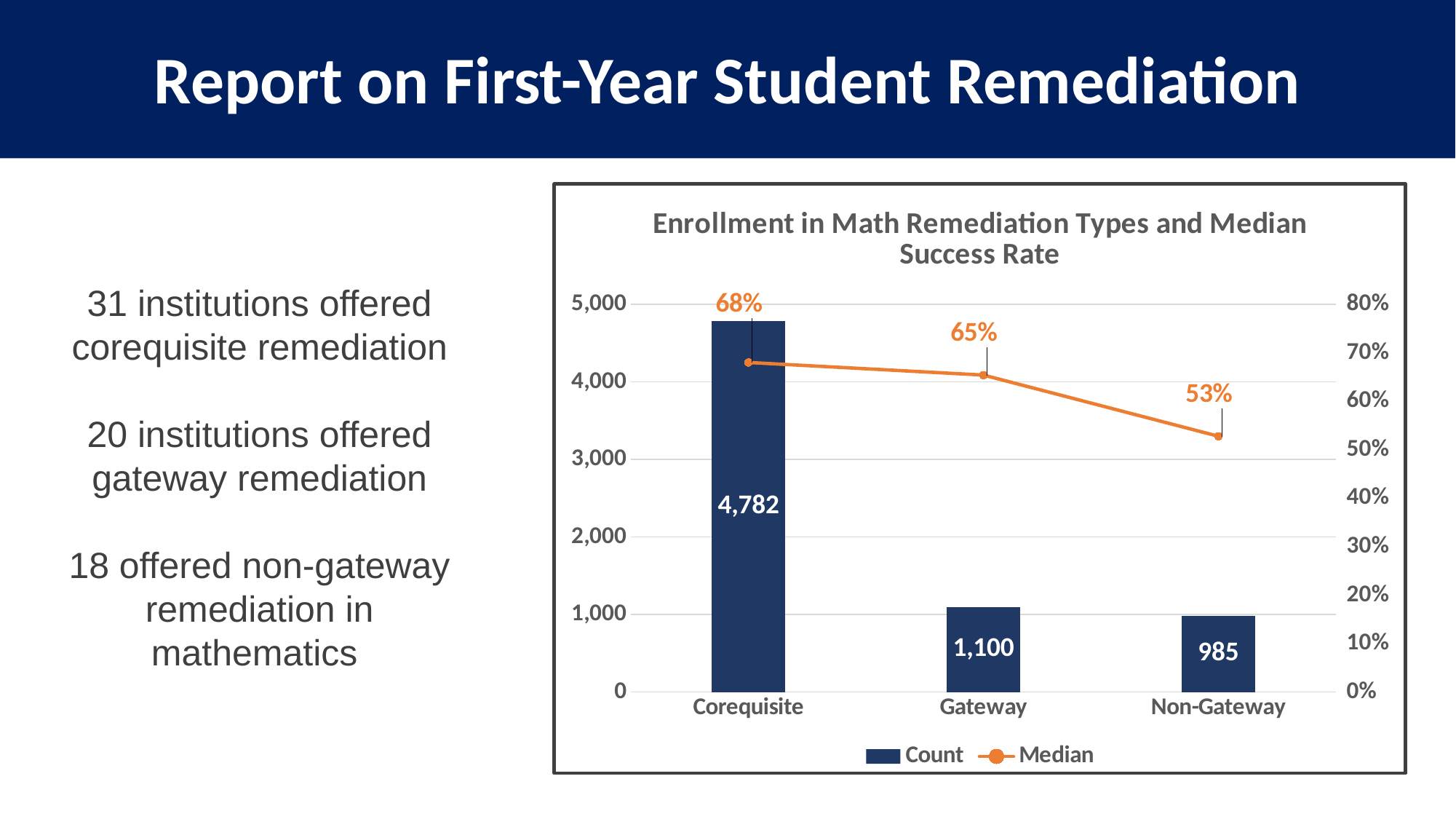
What is the Median success rate for Corequisite? 68% What is the difference in Count between Corequisite and Gateway? 3,682 Which has a larger Count, Gateway or Non-Gateway? Gateway How many series does the legend list? 2 Which remediation type has the lowest Median success rate? Non-Gateway How many remediation types are shown on the x axis? 3 Does the Median success rate rise or fall from Corequisite to Non-Gateway? fall What is the difference in Median success rate between Corequisite and Non-Gateway? 15% Which remediation type has the highest Count? Corequisite What is the Count for Gateway? 1,100 What is the Median success rate for Non-Gateway? 53% What is the Count for Corequisite? 4,782